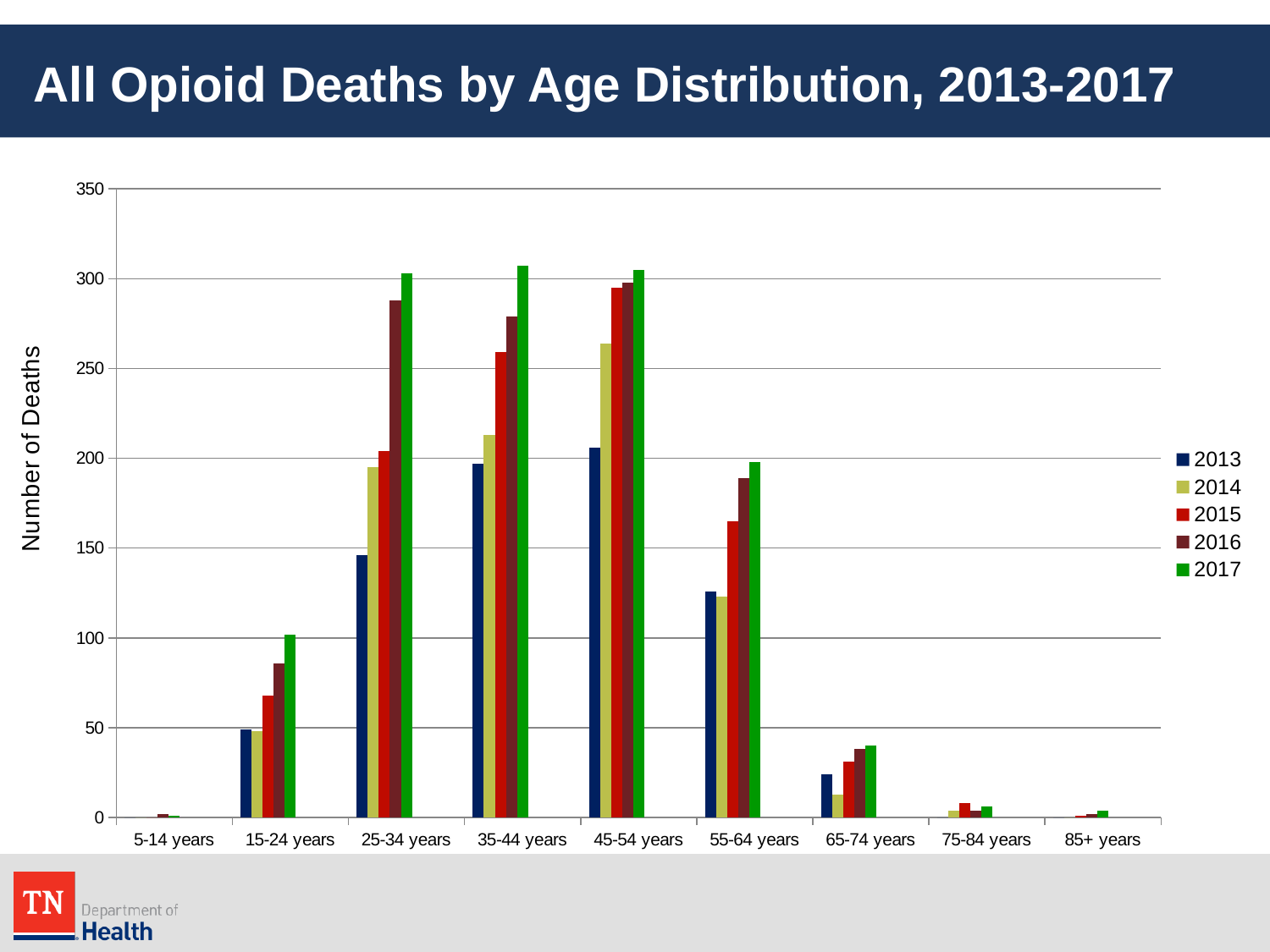
Which year has the lowest number of deaths in the 65-74 years group? 2014 What is the label on the y axis? Number of Deaths How many series does the legend list? 5 Is the 2016 value for 25-34 years greater or less than 250? greater In the 25-34 years group, do the values rise or fall from 2013 to 2017? rise Is the 2013 value for 65-74 years greater or less than 50? less Which year has the highest number of deaths in the 15-24 years group? 2017 What kind of chart is shown on the slide? bar chart Is the 2016 value for 15-24 years greater or less than 100? less How many age groups are shown on the x axis? 9 In the 55-64 years group, which is larger: the 2013 value or the 2016 value? 2016